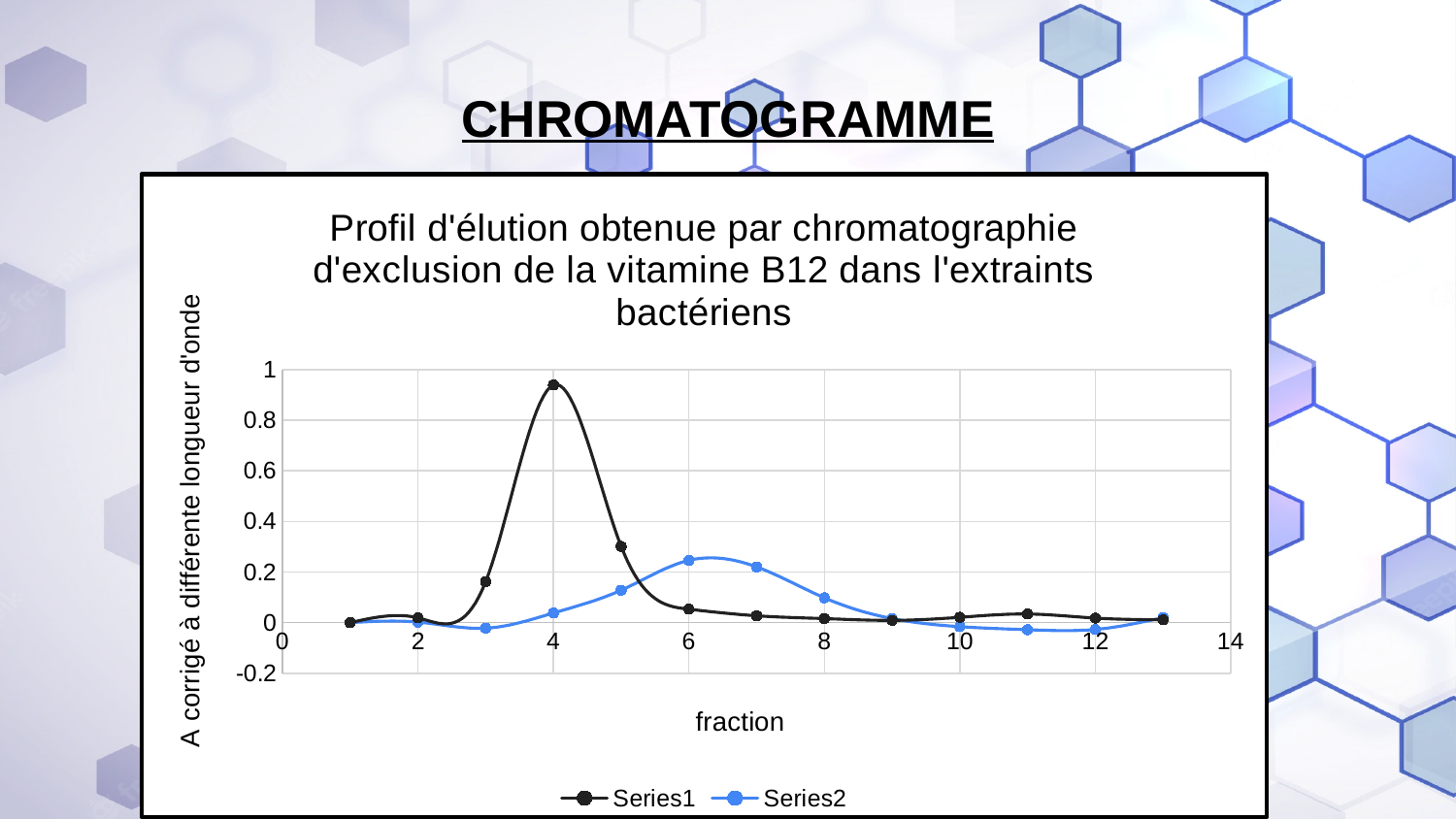
What are the names of the two series in the legend? Series1 and Series2 At which fraction does Series1 reach its highest value? 4 How many series does the legend list? 2 Is the value of Series2 at fraction 6 greater or less than 0.4? less At fraction 4, which series has the larger value, Series1 or Series2? Series1 Which series reaches the higher peak value, Series1 or Series2? Series1 Do the values of Series1 rise or fall between fraction 4 and fraction 9? fall Is the value of Series2 at fraction 8 greater or less than 0.2? less What is the label of the x axis? fraction Is the value of Series1 at fraction 5 greater or less than 0.2? greater What kind of chart is shown on the slide? line chart